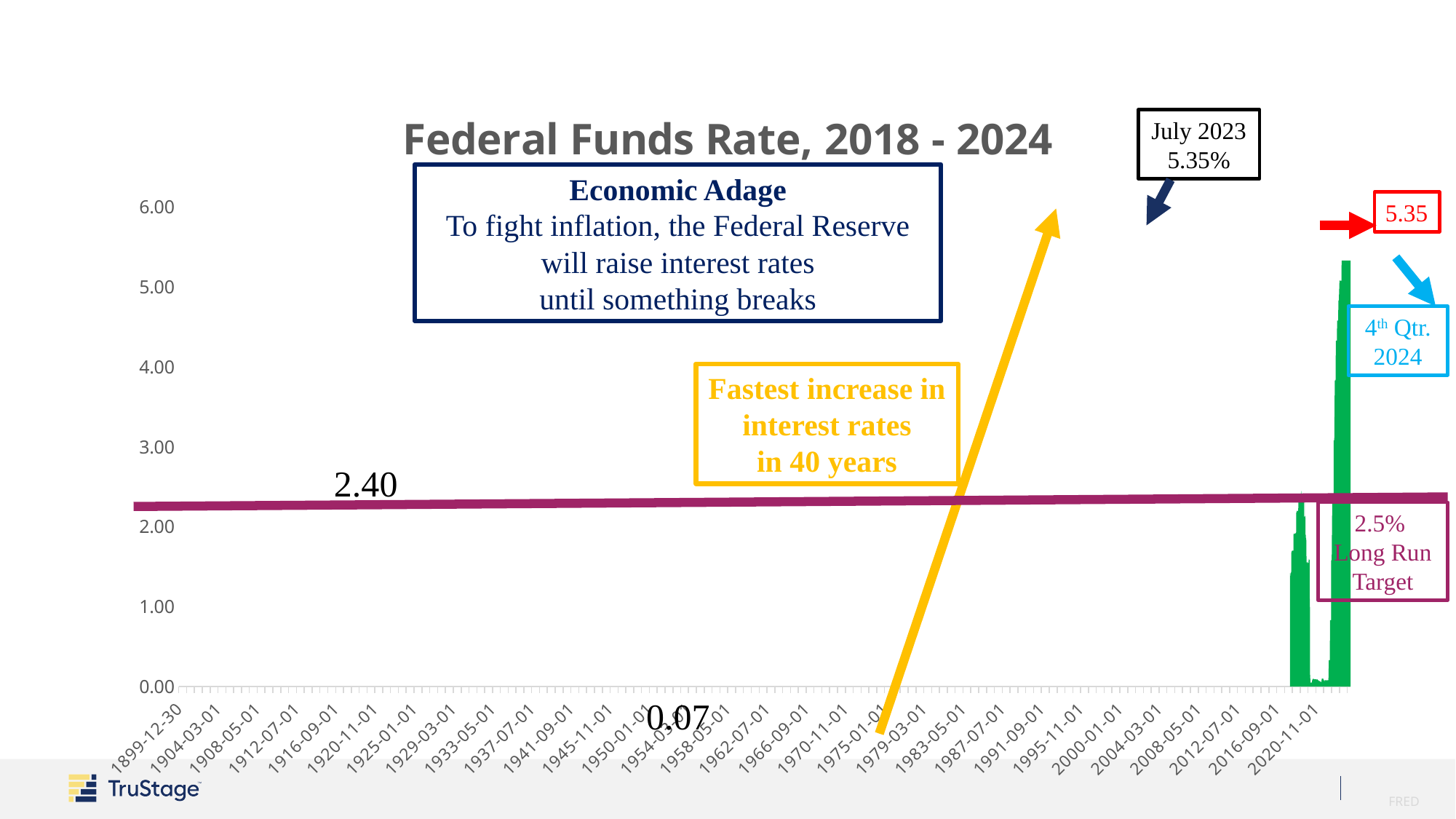
Is the peak of the green line greater or less than 6.00? less Does the green line rise or fall in the final years shown on the chart? rise Is the peak of the green line greater or less than 5.00? greater What is the long run target rate shown in the purple box? 2.5% What federal funds rate is labeled for July 2023? 5.35% What value is labeled on the purple horizontal line? 2.40 What is the title of the chart? Federal Funds Rate, 2018 - 2024 What kind of chart is shown? line chart What is the lowest value labeled on the chart near the bottom of the plot? 0.07 What is the difference between the July 2023 rate of 5.35 and the 2.40 line? 2.95 What is the difference between the labeled values 5.35 and 0.07? 5.28 Which is larger, the July 2023 rate or the long run target? July 2023 rate